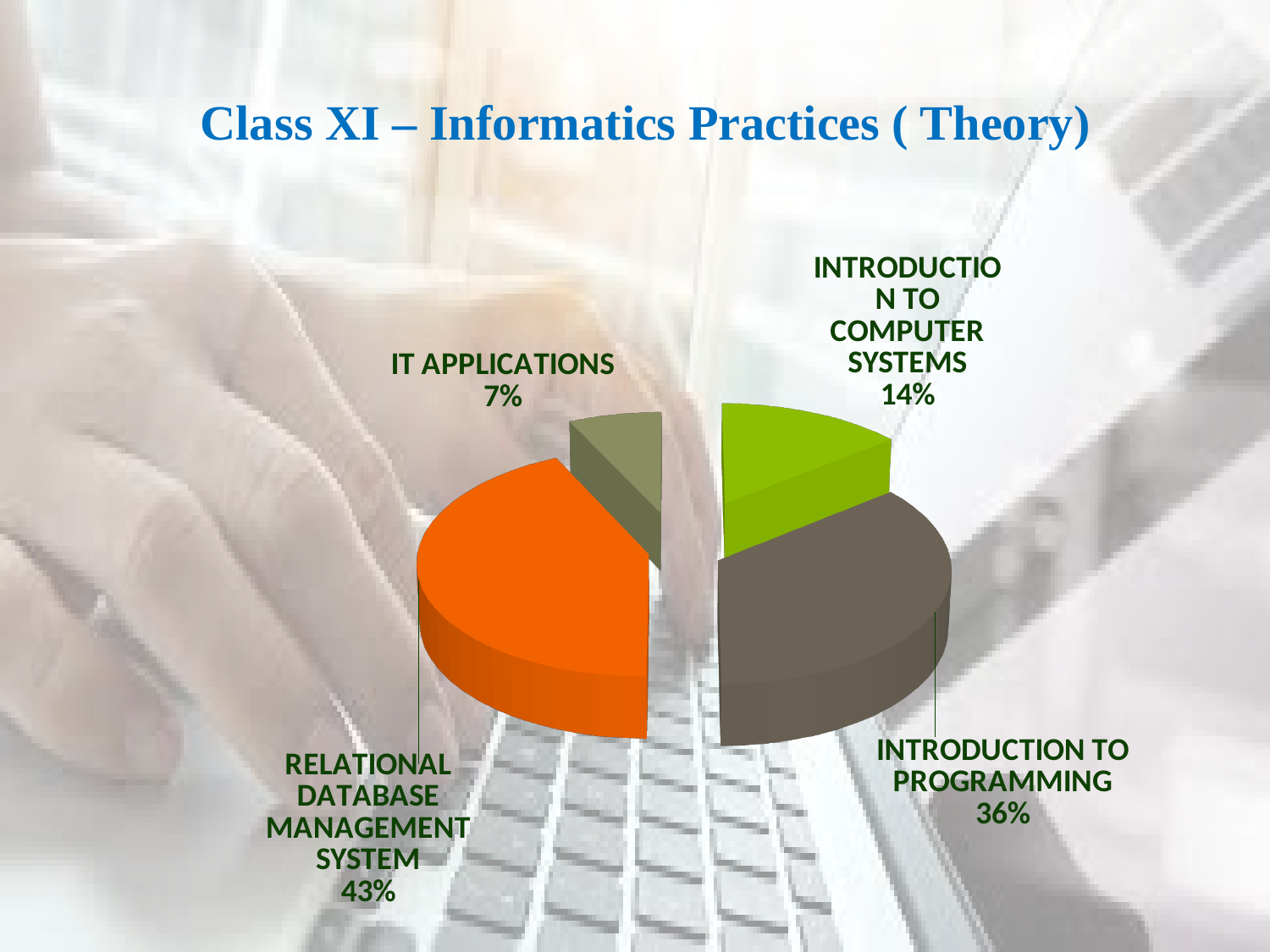
Which is larger, the share for Introduction to Computer Systems or the share for IT Applications? Introduction to Computer Systems What colour is the slice for Relational Database Management System? orange What percentage is shown for Relational Database Management System? 43% Which category has the smallest share of the pie? IT Applications What kind of chart is shown on the slide? pie chart What percentage is shown for Introduction to Programming? 36% What percentage is shown for Introduction to Computer Systems? 14% How many categories are shown in the pie chart? 4 What percentage is shown for IT Applications? 7% What is the difference in percentage points between Relational Database Management System and Introduction to Programming? 7 What is the title of the slide containing the chart? Class XI – Informatics Practices ( Theory) Which category has the largest share of the pie? Relational Database Management System